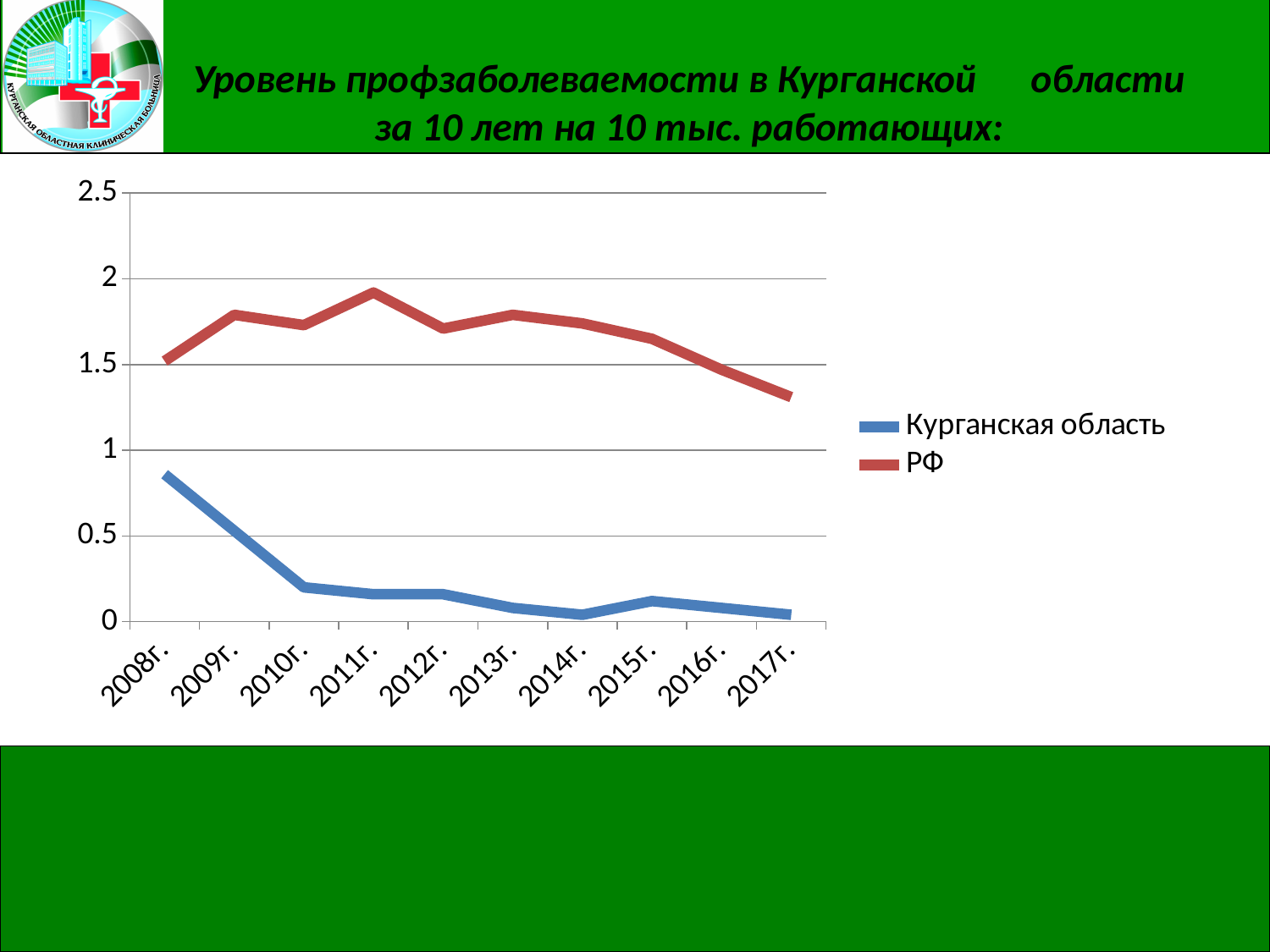
In which year does the РФ series reach its lowest value? 2017г. Is the value for Курганская область in 2010г. greater or less than 0.5? less Does the Курганская область series generally rise or fall from 2008г. to 2017г.? fall In which year does the Курганская область series reach its highest value? 2008г. In which year does the РФ series reach its highest value? 2011г. What kind of chart is shown on the slide? line chart Which series has the larger value in 2008г., Курганская область or РФ? РФ Which series is shown in red in the legend? РФ How many series does the legend list? 2 Is the value for Курганская область in 2008г. greater or less than 0.5? greater Is the value for РФ in 2011г. greater or less than 1.5? greater How many years are plotted along the x axis? 10